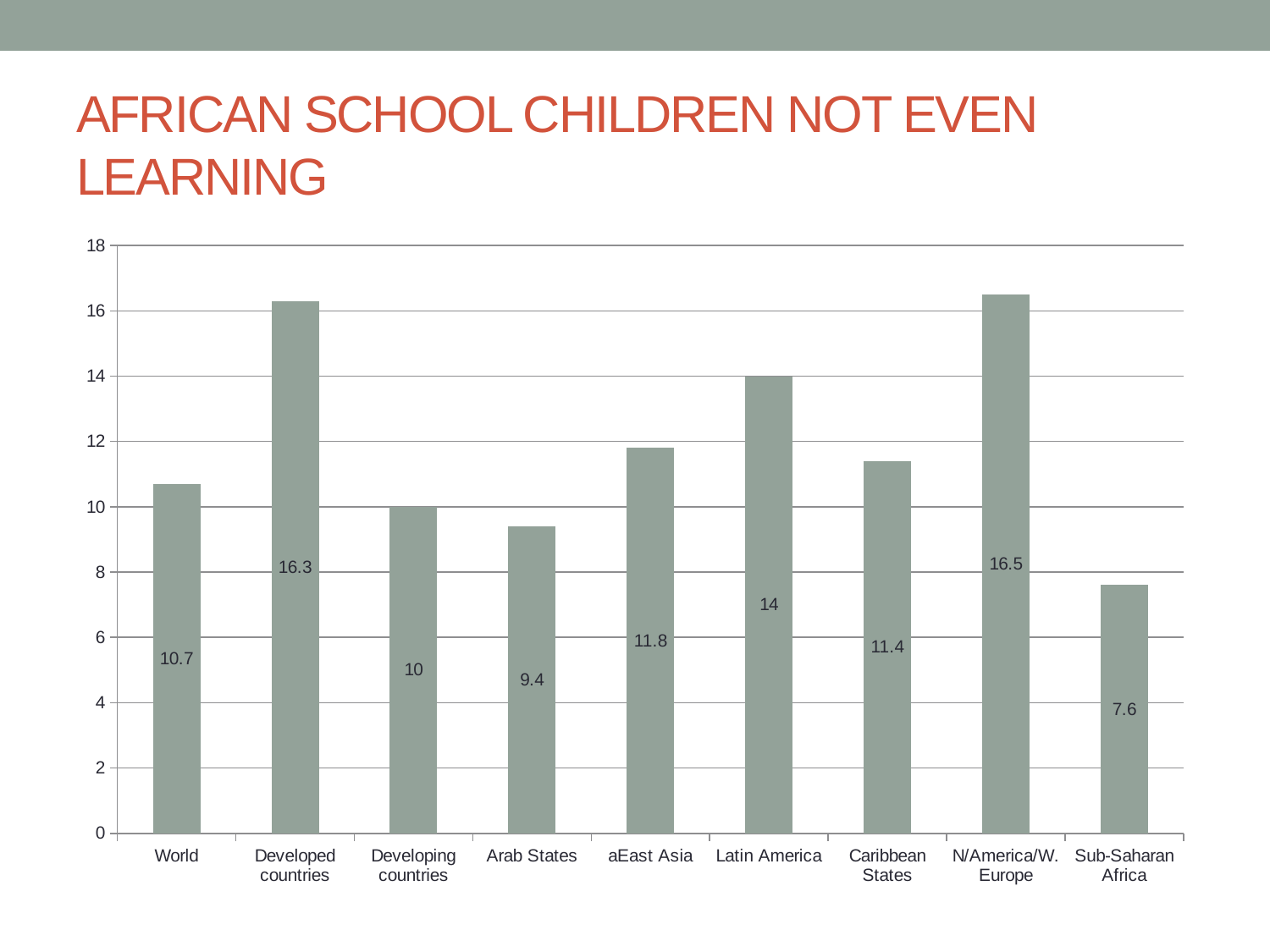
What kind of chart is shown on the slide? bar chart What is the value for Sub-Saharan Africa? 7.6 What is the value for Arab States? 9.4 Which category has the lowest value? Sub-Saharan Africa Which category has the highest value? N/America/W. Europe How many categories are shown on the x axis? 9 What is the value for Latin America? 14 What is the title of the slide? AFRICAN SCHOOL CHILDREN NOT EVEN LEARNING What is the value for Developed countries? 16.3 What is the difference between the values for N/America/W. Europe and Sub-Saharan Africa? 8.9 Which is larger, the value for Caribbean States or the value for Developing countries? Caribbean States Is the value for World greater or less than 12? less